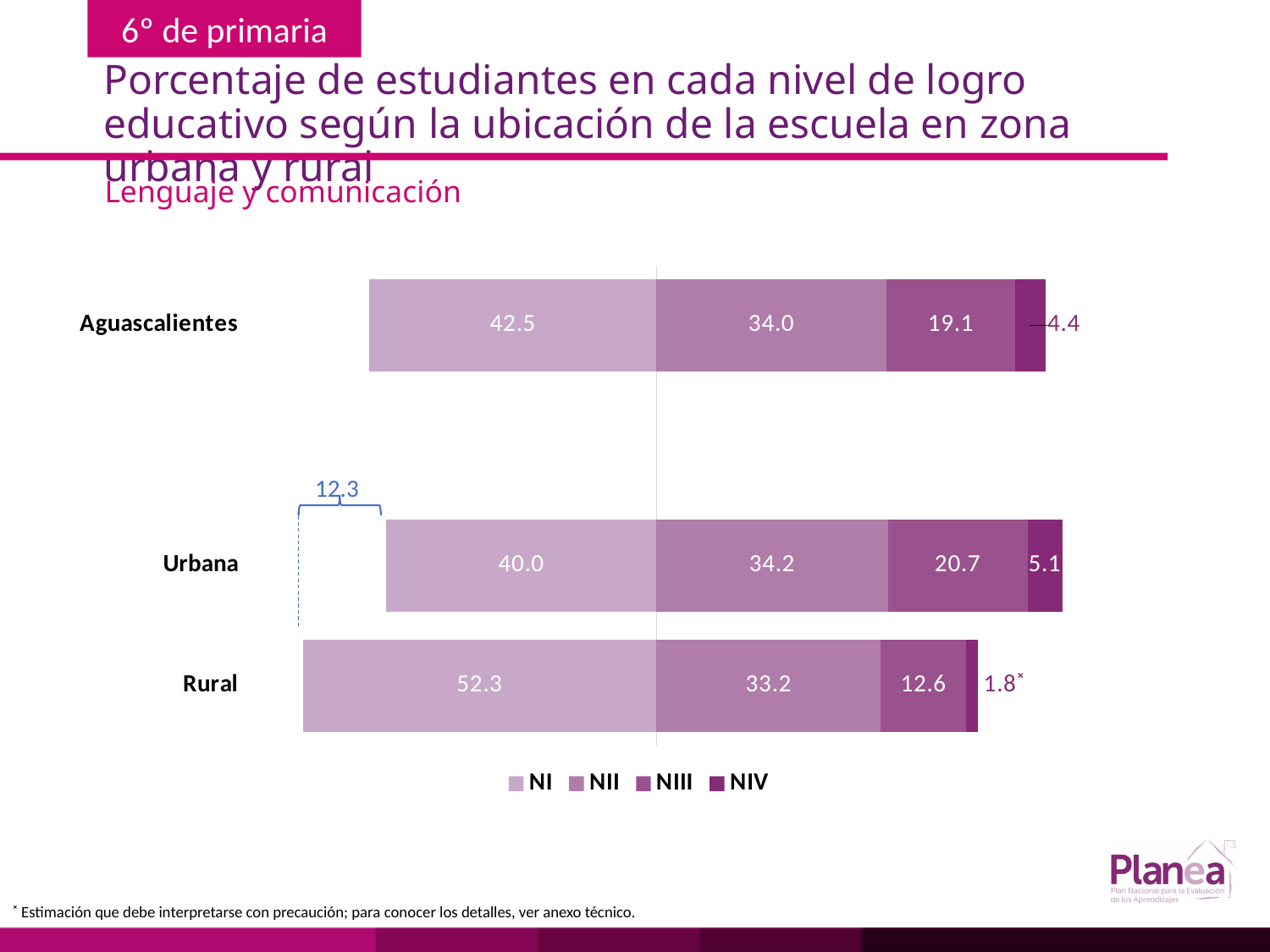
What is the NIV value for Aguascalientes? 4.4 How many categories (bars) are plotted in the chart? 3 Which series is shown in the lightest shade in the legend? NI What is the NIII value for Urbana? 20.7 What is the NII value for Rural? 33.2 What is the NI value for Rural? 52.3 Which category has the highest NI value? Rural What type of chart is shown on the slide? Stacked bar chart How many series does the legend list? 4 Which category has the lowest NIV value? Rural Which is larger, the NIII value for Urbana or the NIII value for Aguascalientes? Urbana What is the difference between the NI values for Rural and Urbana? 12.3